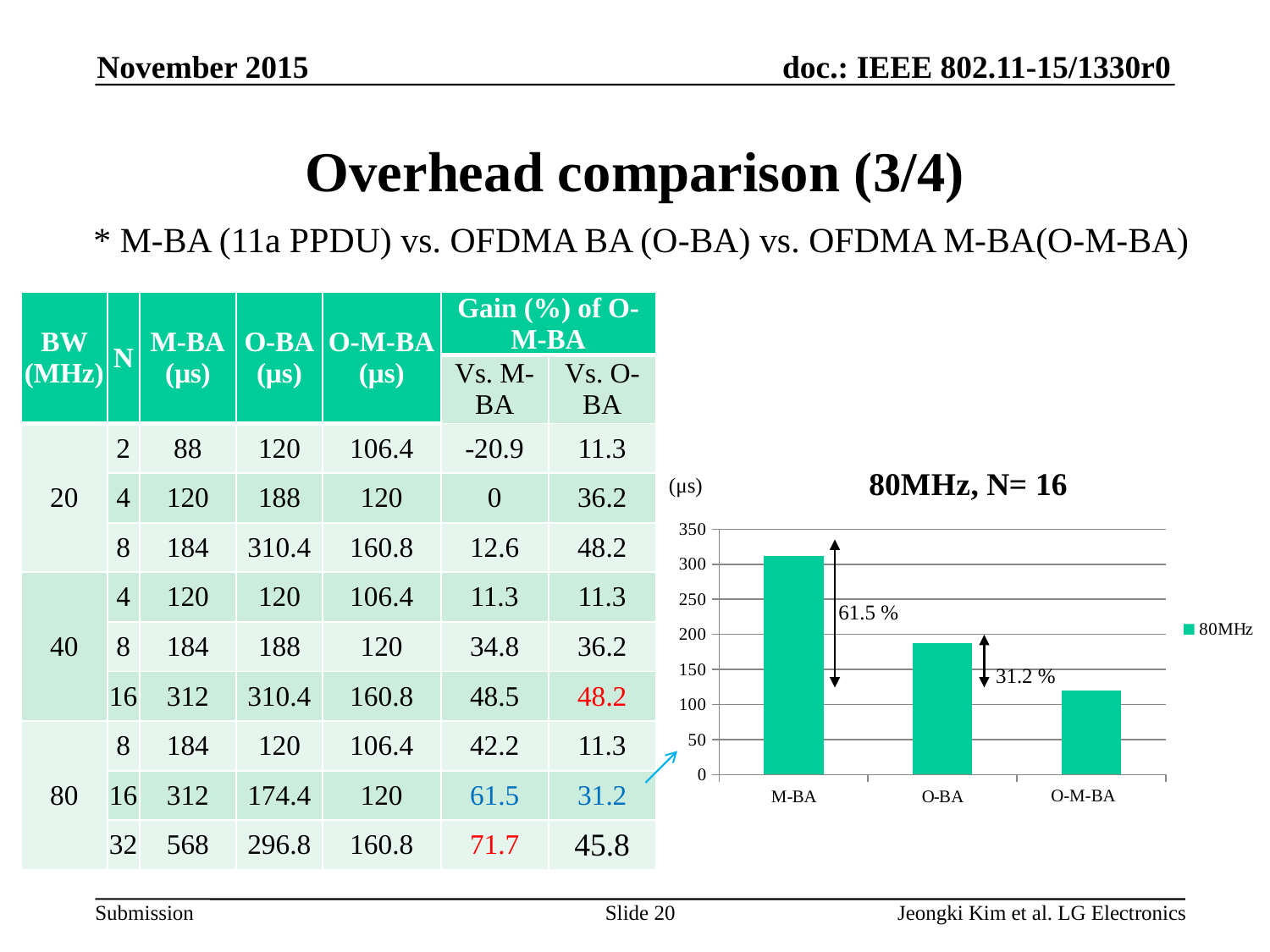
What percentage is annotated between the M-BA and O-BA bars in the chart? 61.5 % What is the title of the chart? 80MHz, N= 16 Is the value for M-BA greater or less than 250? greater What kind of chart is shown on the slide? bar chart Is the value for O-M-BA greater or less than 150? less How many series does the chart legend list? 1 Which bar is taller, M-BA or O-BA? M-BA How many bars are plotted in the chart? 3 Do the bar values rise or fall from M-BA to O-M-BA along the x axis? fall Which category has the highest bar in the chart? M-BA Is the value for O-BA greater or less than 200? less Which category has the lowest bar in the chart? O-M-BA